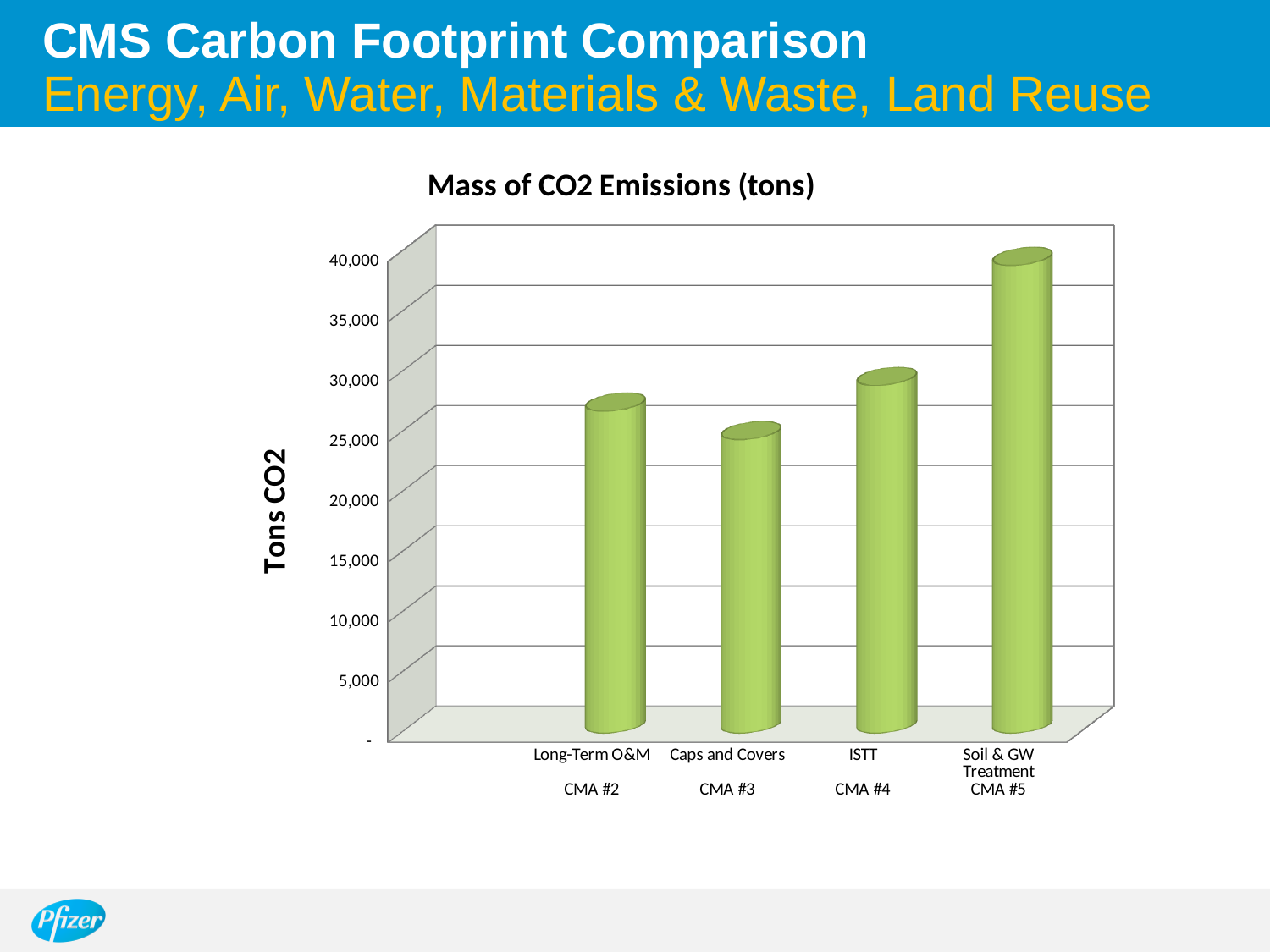
Which has higher CO2 emissions, ISTT or Long-Term O&M? ISTT Which has higher CO2 emissions, Soil & GW Treatment or ISTT? Soil & GW Treatment What is the label on the vertical axis of the chart? Tons CO2 Is the value for Caps and Covers greater or less than 30,000? less Is the value for Soil & GW Treatment greater or less than 35,000? greater Is the value for ISTT greater or less than 25,000? greater How many categories are plotted in the chart? 4 Which category has the lowest mass of CO2 emissions? Caps and Covers (CMA #3) What is the title of the chart? Mass of CO2 Emissions (tons) Which category has the highest mass of CO2 emissions? Soil & GW Treatment (CMA #5) What type of chart is shown on the slide? Bar chart